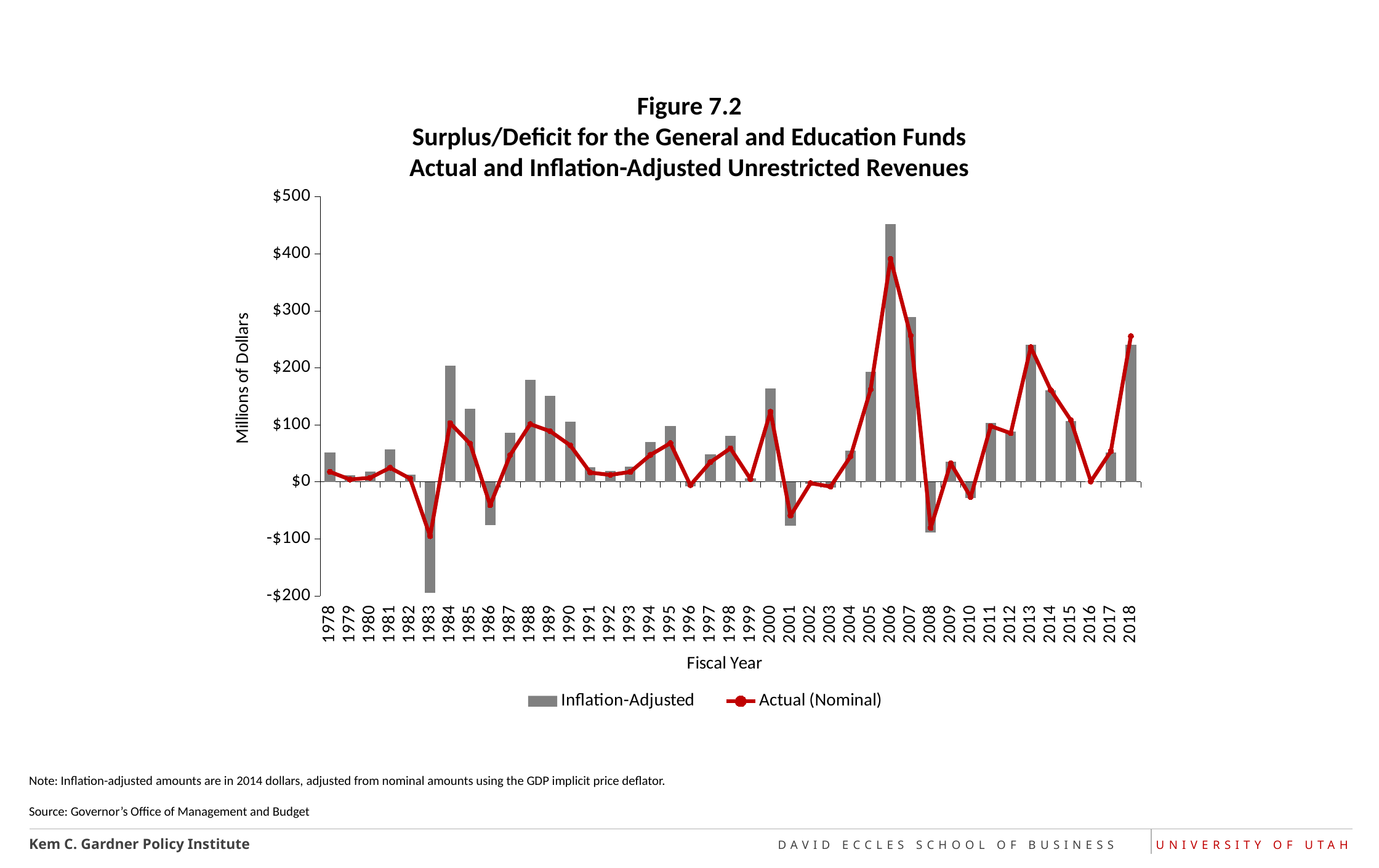
What is the label of the y axis? Millions of Dollars What kind of chart is shown on the slide? A combined bar and line chart Which fiscal year has the larger Inflation-Adjusted value, 2006 or 2007? 2006 How many fiscal years are plotted along the x axis? 41 Which series is drawn as a red line with markers? Actual (Nominal) In which fiscal year is the Inflation-Adjusted bar the lowest? 1983 In which fiscal year does the Actual (Nominal) line reach its highest point? 2006 In which fiscal year is the Inflation-Adjusted bar the highest? 2006 Is the Actual (Nominal) value for 2006 greater or less than $300? greater Is the Inflation-Adjusted value for 2006 greater or less than $400? greater How many series does the legend list? 2 Is the Inflation-Adjusted value for 1983 greater or less than -$100? less